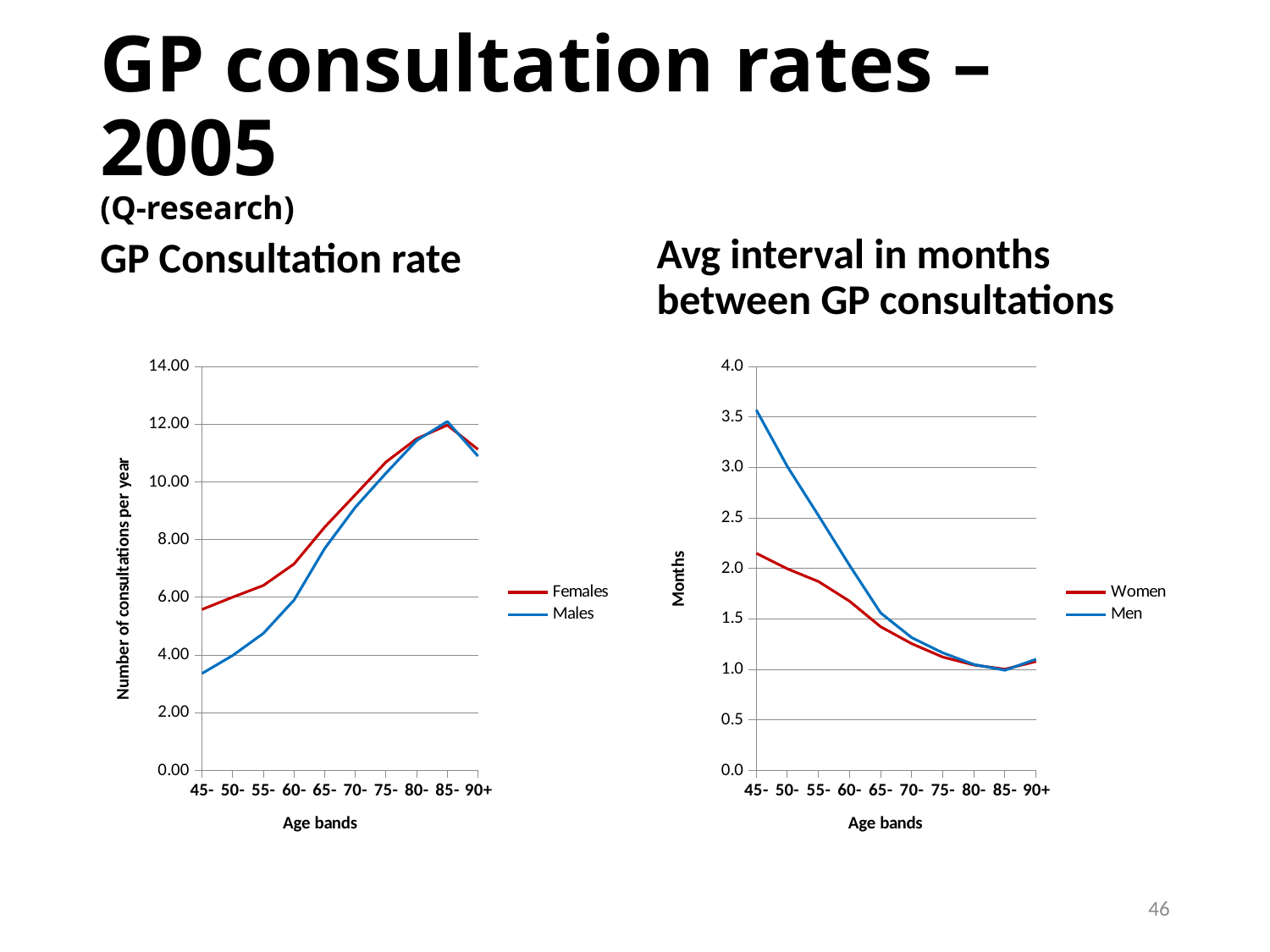
In the 'Avg interval in months between GP consultations' chart, do the Men values rise or fall from age band 45- to 85-? fall In the 'Avg interval in months between GP consultations' chart, which series has the higher value at age band 45-, Women or Men? Men In the 'GP Consultation rate' chart, is the value for Males at age band 45- greater or less than 4.00? less In the 'GP Consultation rate' chart, at which age band does the Males series reach its highest value? 85- In the 'GP Consultation rate' chart, do the Females values rise or fall from age band 45- to 85-? rise In the 'GP Consultation rate' chart, is the value for Females at age band 75- greater or less than 10.00? greater How many series does the legend of the 'GP Consultation rate' chart list? 2 What type of chart is the 'GP Consultation rate' chart? line chart How many age bands are shown on the x axis of the 'GP Consultation rate' chart? 10 What is the y-axis label of the 'GP Consultation rate' chart? Number of consultations per year In the 'GP Consultation rate' chart, which series has the higher value at age band 45-, Females or Males? Females In the 'Avg interval in months between GP consultations' chart, is the value for Men at age band 45- greater or less than 3.0? greater